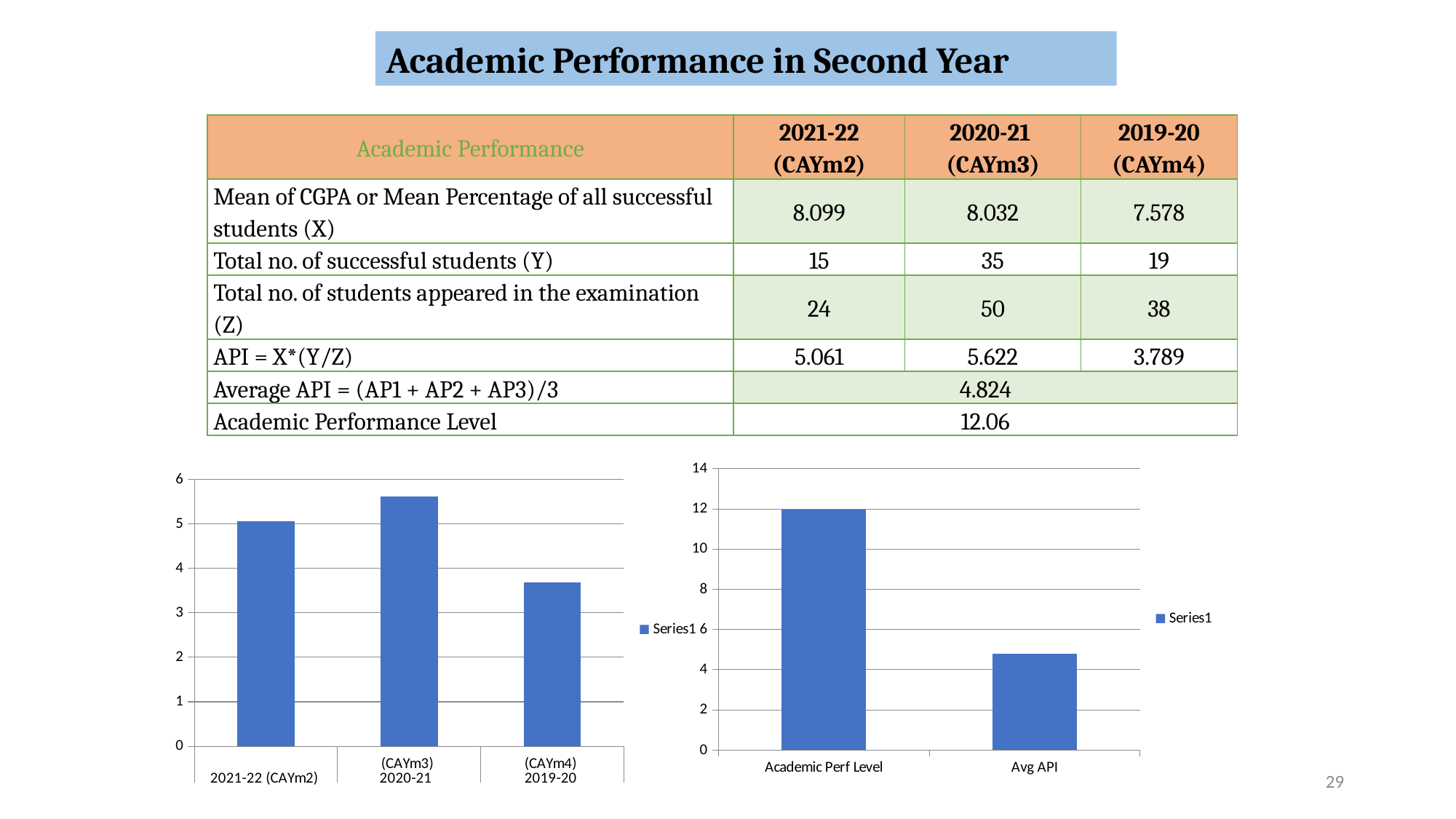
In the right chart, is the value for Avg API greater or less than 6? less In the left chart, is the value for 2021-22 (CAYm2) greater or less than 4? greater In the left chart, which is larger, the value for 2021-22 (CAYm2) or the value for 2019-20 (CAYm4)? 2021-22 (CAYm2) In the left chart, is the value for 2020-21 (CAYm3) greater or less than 5? greater In the left chart, which category has the highest bar? 2020-21 (CAYm3) In the left chart, does the value rise or fall from 2020-21 (CAYm3) to 2019-20 (CAYm4)? fall How many series does the legend of the right chart list? 1 In the right chart, which category has the higher bar? Academic Perf Level In the left chart, which category has the lowest bar? 2019-20 (CAYm4) How many categories are shown in the left chart? 3